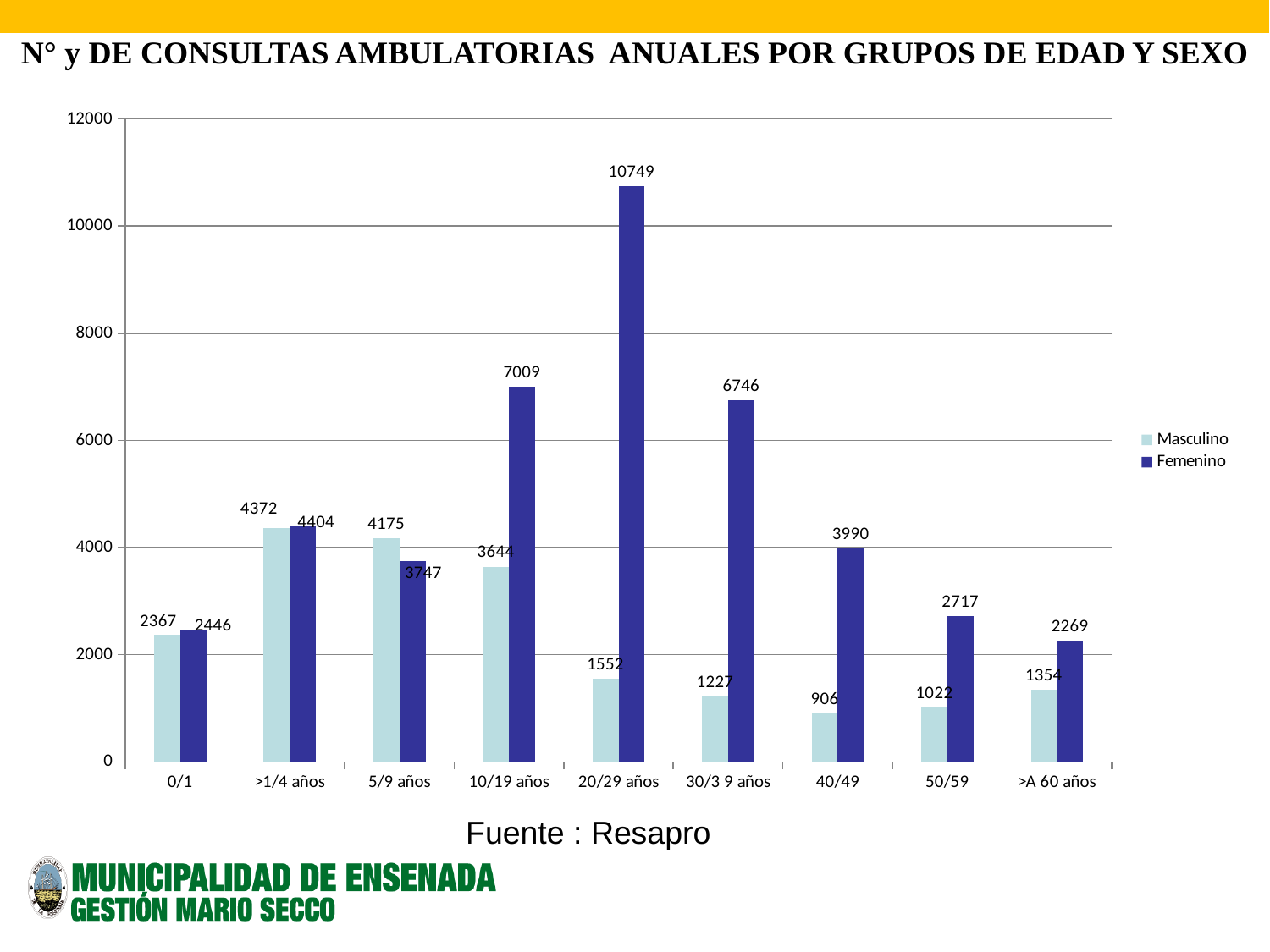
What is the Femenino value for the 20/29 años group? 10749 Which age group has the highest Femenino value? 20/29 años How many series does the legend list? 2 What is the Masculino value for the 5/9 años group? 4175 What source is cited below the chart? Resapro What is the difference between the Femenino and Masculino values for the 10/19 años group? 3365 How many age groups are shown on the x axis? 9 What kind of chart is shown on the slide? bar chart Which is larger for the 5/9 años group, Masculino or Femenino? Masculino Which age group has the lowest Masculino value? 40/49 What is the Femenino value for the 50/59 group? 2717 Is the Femenino value for the 30/3 9 años group greater or less than 6000? greater